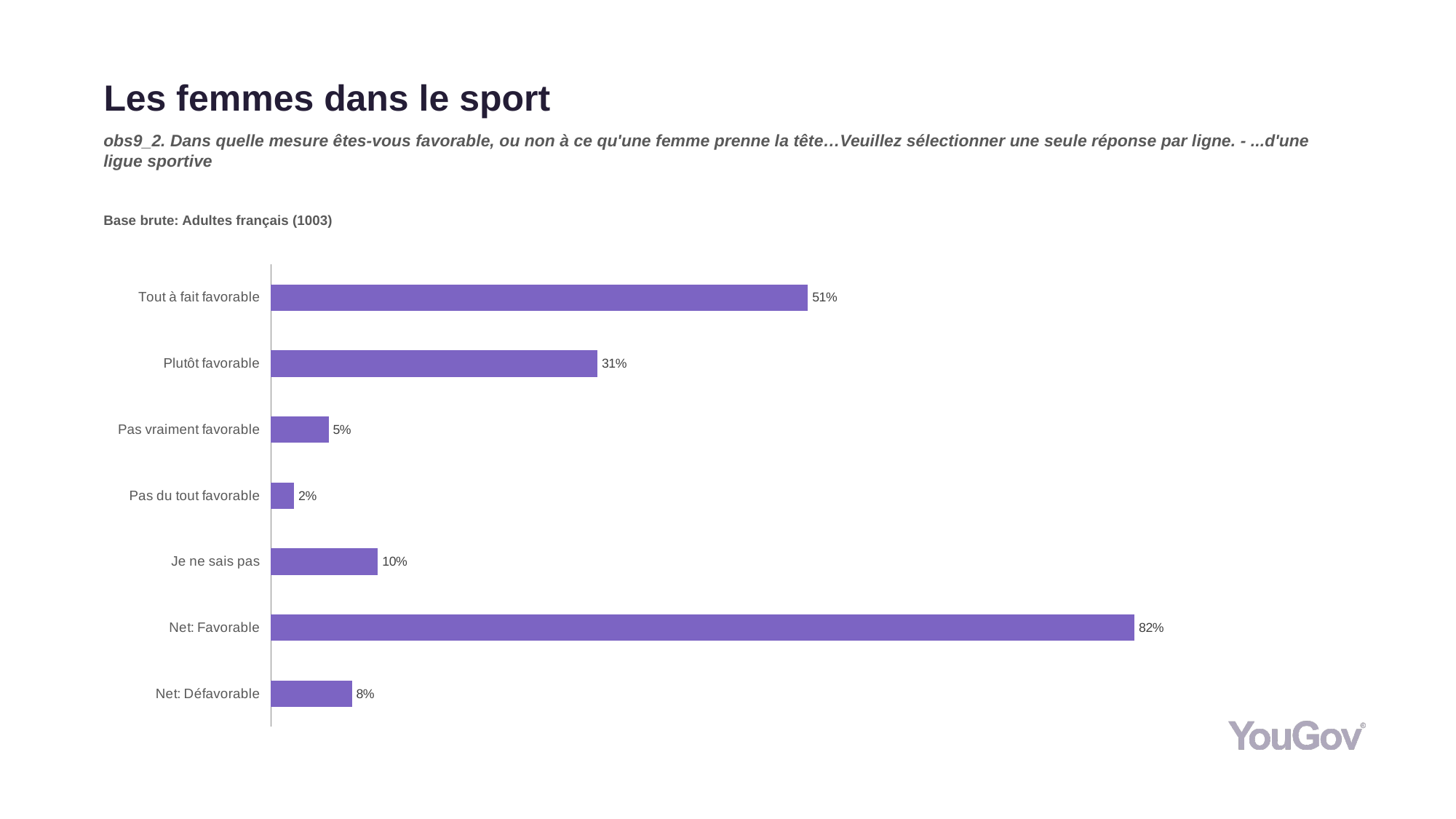
What is the value for "Net: Défavorable"? 8% What is the value for "Pas du tout favorable"? 2% Which is larger, "Pas vraiment favorable" or "Je ne sais pas"? Je ne sais pas What is the difference between "Tout à fait favorable" and "Plutôt favorable"? 20 percentage points Which category has the lowest value? Pas du tout favorable What is the value for "Tout à fait favorable"? 51% Which category has the highest value? Net: Favorable What kind of chart is shown on the slide? Bar chart How many categories are shown in the chart? 7 What is the value for "Je ne sais pas"? 10% What is the base (sample) stated on the slide? Adultes français (1003) What is the value for "Plutôt favorable"? 31%